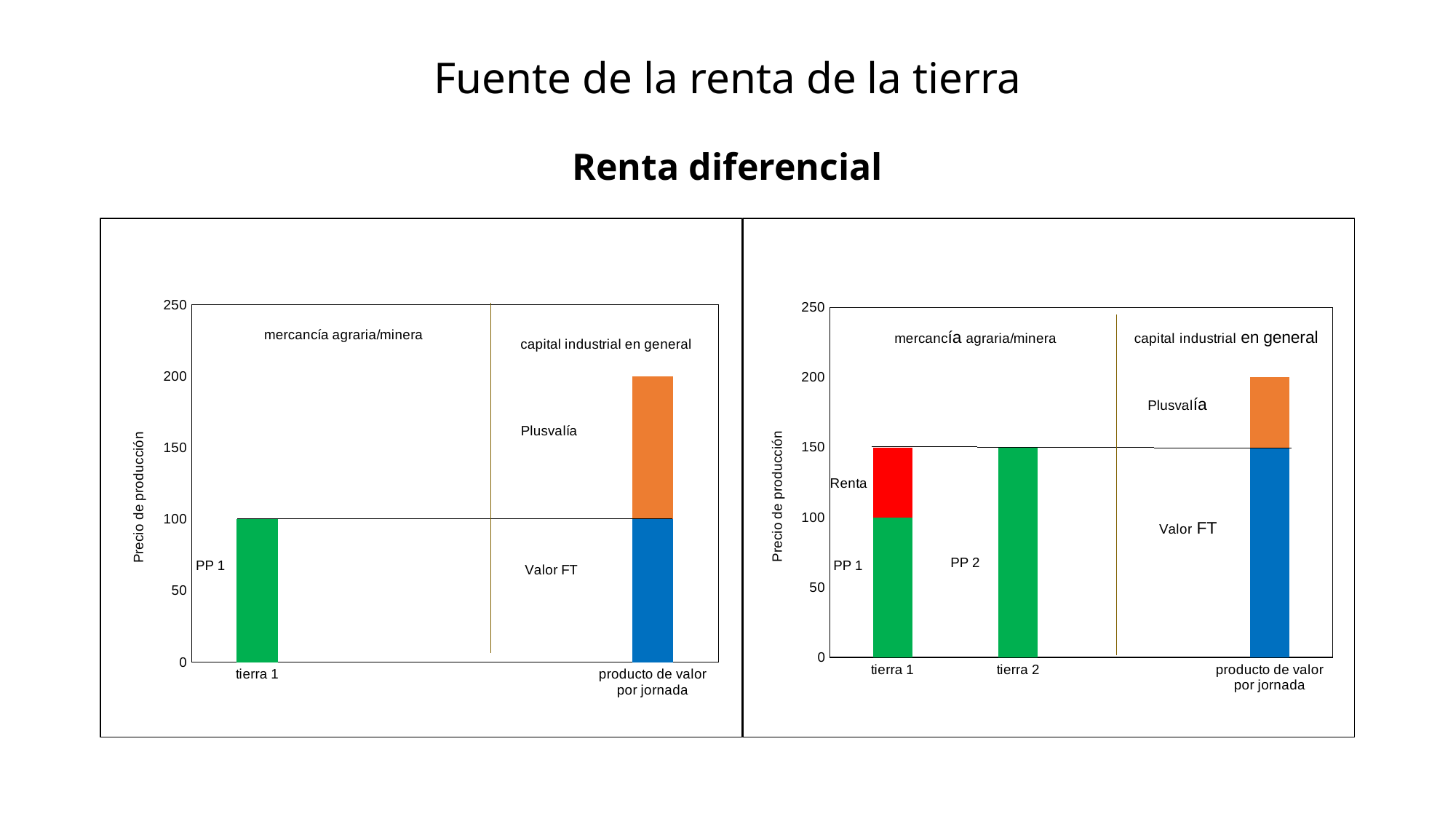
On the right chart, what is the label of the y axis? Precio de producción On the left chart, what is the total height of the stacked bar for producto de valor por jornada? 200 On the left chart, how many categories are shown on the x axis? 2 On the right chart, what is the difference between the total for producto de valor por jornada and the total for tierra 2? 50 On the left chart, what kind of chart is shown? bar chart On the left chart, what is the value of the blue Valor FT segment for producto de valor por jornada? 100 On the right chart, what is the total height of the stacked bar for tierra 1? 150 On the right chart, which category has the highest total bar? producto de valor por jornada On the left chart, what is the value of the green bar for tierra 1? 100 On the right chart, what is the total height of the stacked bar for producto de valor por jornada? 200 On the right chart, what is the value of the green bar for tierra 2? 150 On the right chart, how many categories are shown on the x axis? 3